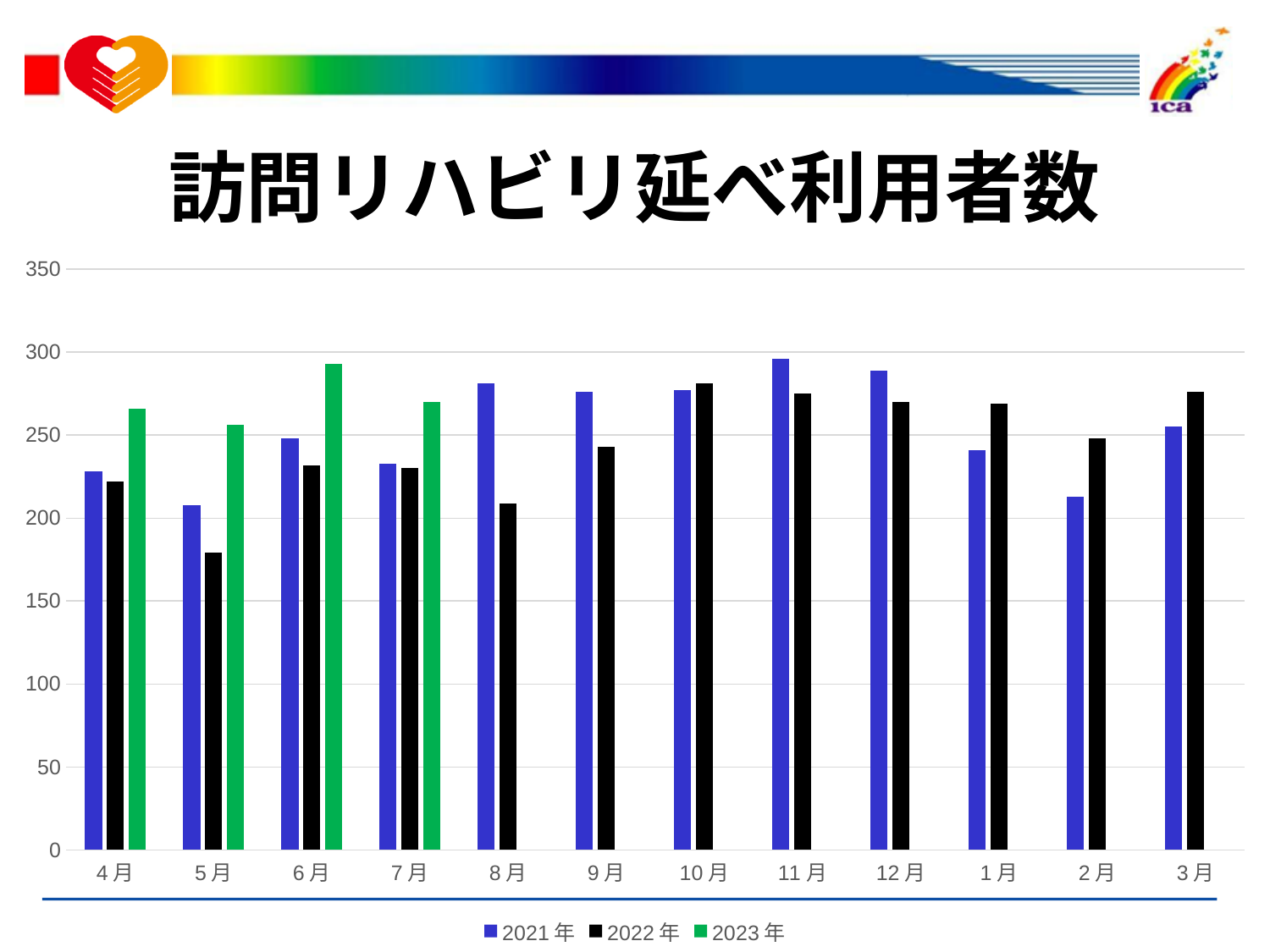
Is the 2021年 value for 11月 greater or less than 250? greater In 1月, which series has the larger value, 2021年 or 2022年? 2022年 In which month is the 2023年 value highest? 6月 Is the 2022年 value for 5月 greater or less than 200? less How many months are shown on the x axis? 12 In which month is the 2022年 value lowest? 5月 For how many months is a 2023年 bar plotted? 4 What kind of chart is shown on the slide? bar chart In which month is the 2021年 value highest? 11月 Is the 2023年 value for 6月 greater or less than 250? greater In 8月, which series has the larger value, 2021年 or 2022年? 2021年 How many series does the legend list? 3